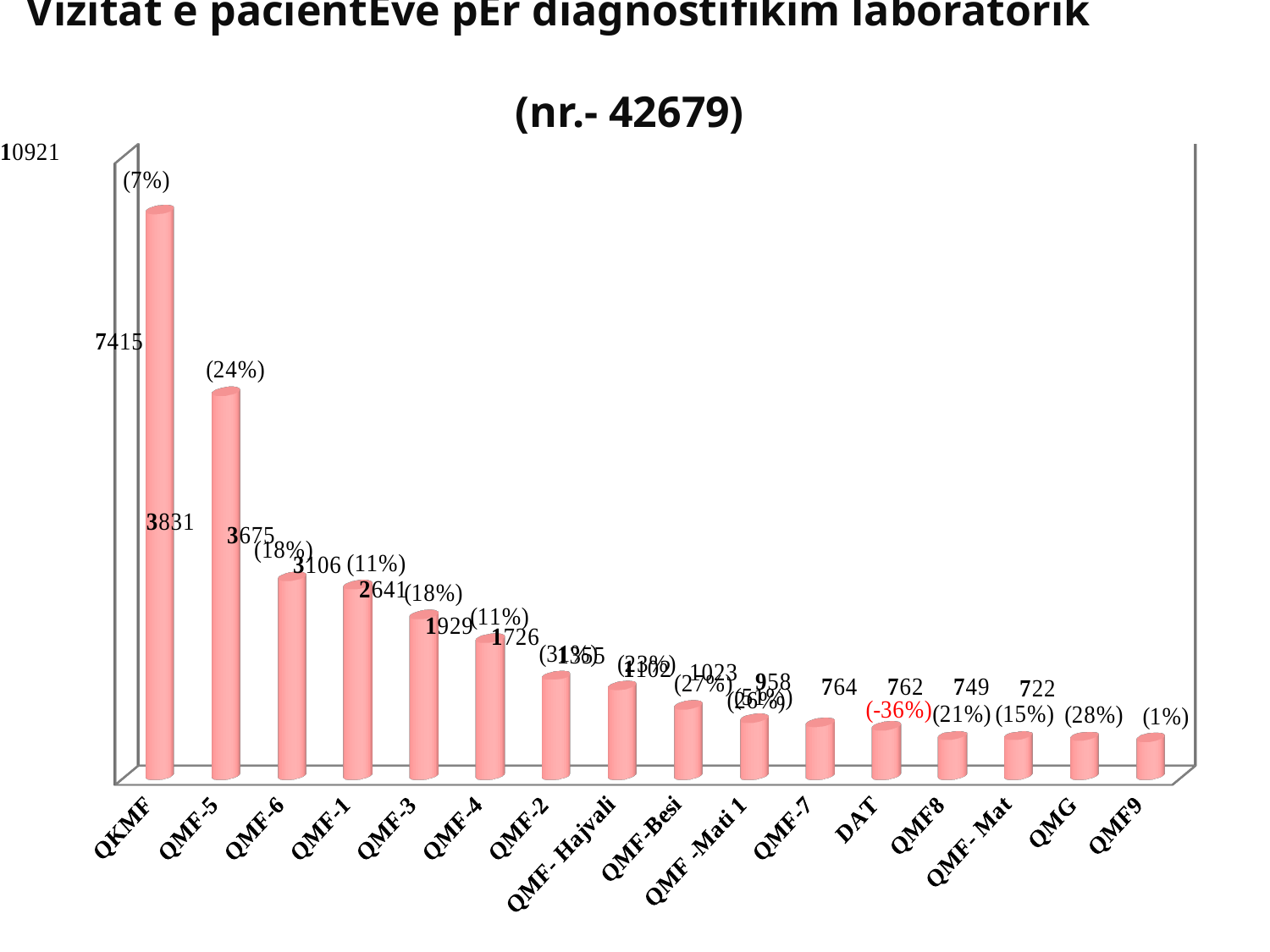
What percentage is shown in parentheses above the QMF-5 bar? (24%) Which category has the highest value in the chart? QKMF What is the value shown for QKMF? 10921 What is the difference between the values for QKMF and QMF-5? 3506 What is the value shown for QMF-5? 7415 Do the bar values rise or fall moving from left to right along the x axis? fall What kind of chart is shown on the slide? bar chart What percentage is shown in parentheses above the DAT bar? (-36%) What percentage is shown in parentheses above the QMF9 bar? (1%) How many categories (bars) are shown in the chart? 16 Which is larger, the value for QKMF or the value for QMF-5? QKMF What total number (nr.) is given in the chart title? 42679